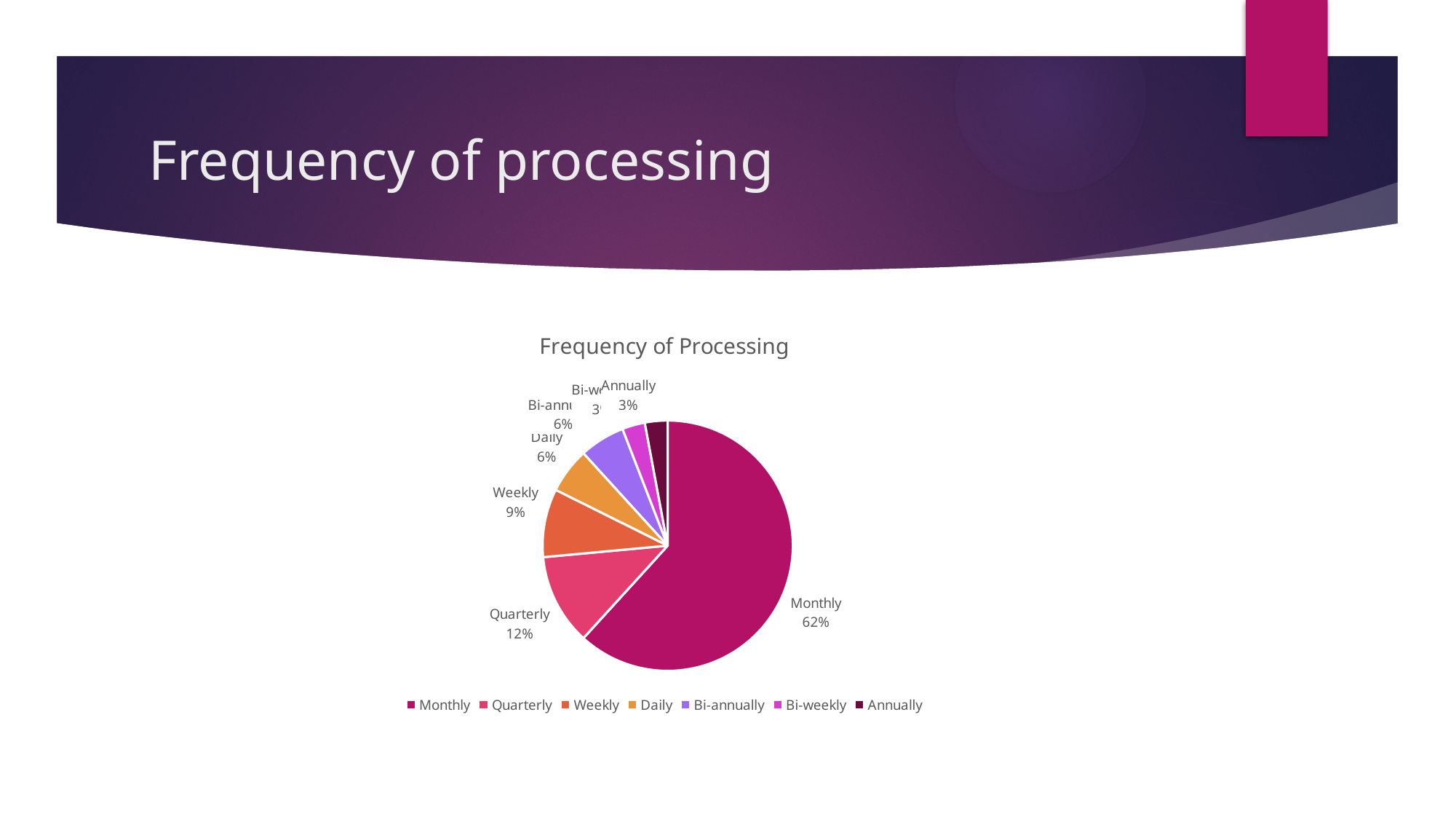
What is the difference between the Monthly and Quarterly shares? 50% What is the title of the chart? Frequency of Processing What is the value shown for Daily? 6% Which category has the largest slice of the pie? Monthly What kind of chart is shown on the slide? pie chart What is the value shown for Weekly? 9% How many categories does the legend list? 7 What is the value shown for Annually? 3% What is the value shown for Quarterly? 12% Which is larger, Quarterly or Weekly? Quarterly What is the difference between the Weekly and Annually shares? 6% What share of the pie does Monthly represent? 62%